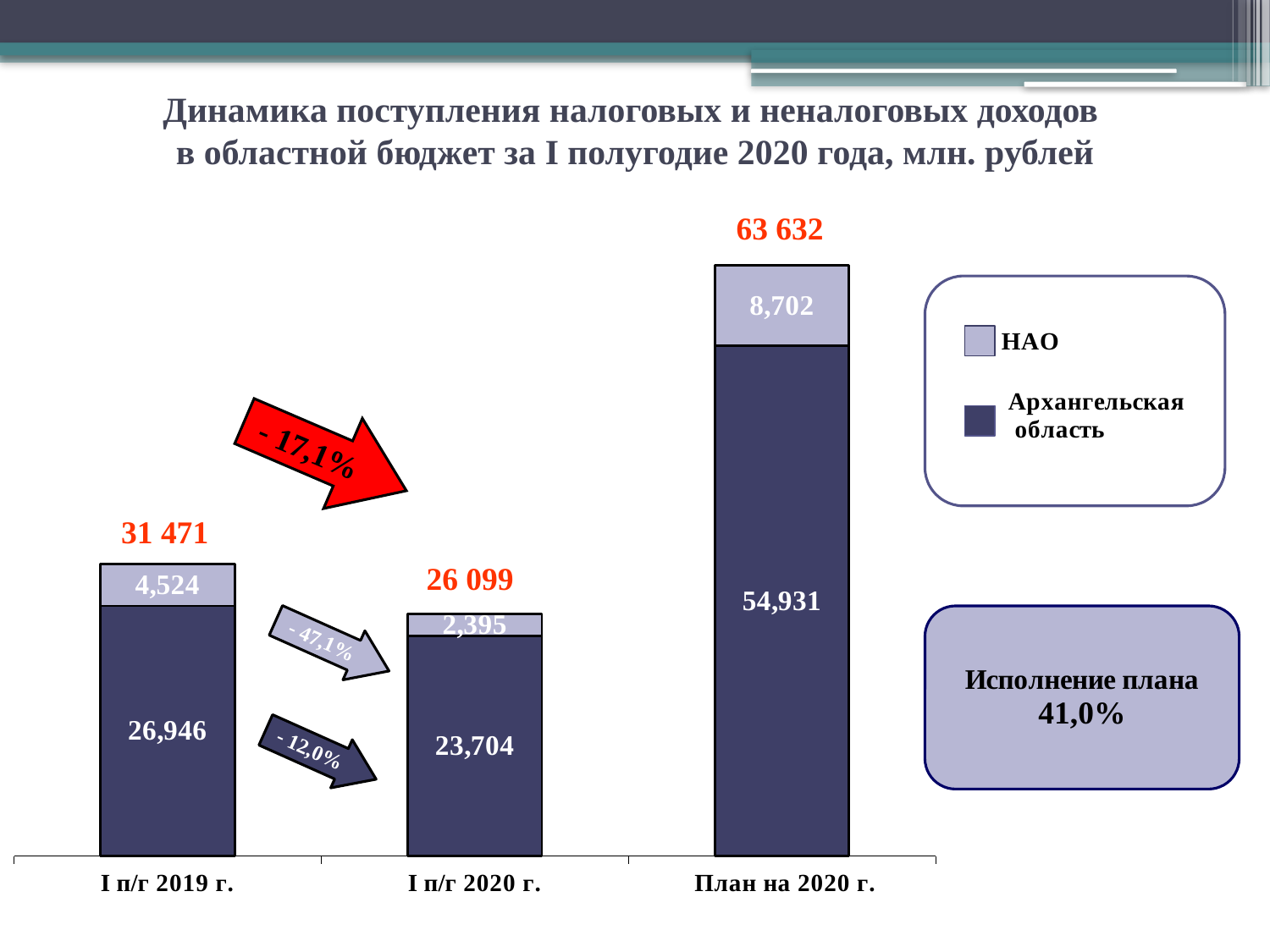
What is the total of the stacked bar for План на 2020 г.? 63 632 What is the total of the stacked bar for I п/г 2020 г.? 26 099 Which category has the highest total? План на 2020 г. Which is larger: the НАО value in I п/г 2019 г. or in I п/г 2020 г.? I п/г 2019 г. What is the value for НАО in I п/г 2020 г.? 2,395 What type of chart is shown on the slide? stacked bar chart How many categories are shown on the x axis of the chart? 3 What is the value for Архангельская область in I п/г 2019 г.? 26,946 What is the value for Архангельская область in План на 2020 г.? 54,931 Which category has the lowest total? I п/г 2020 г. How many series does the legend list? 2 What is the value for НАО in План на 2020 г.? 8,702